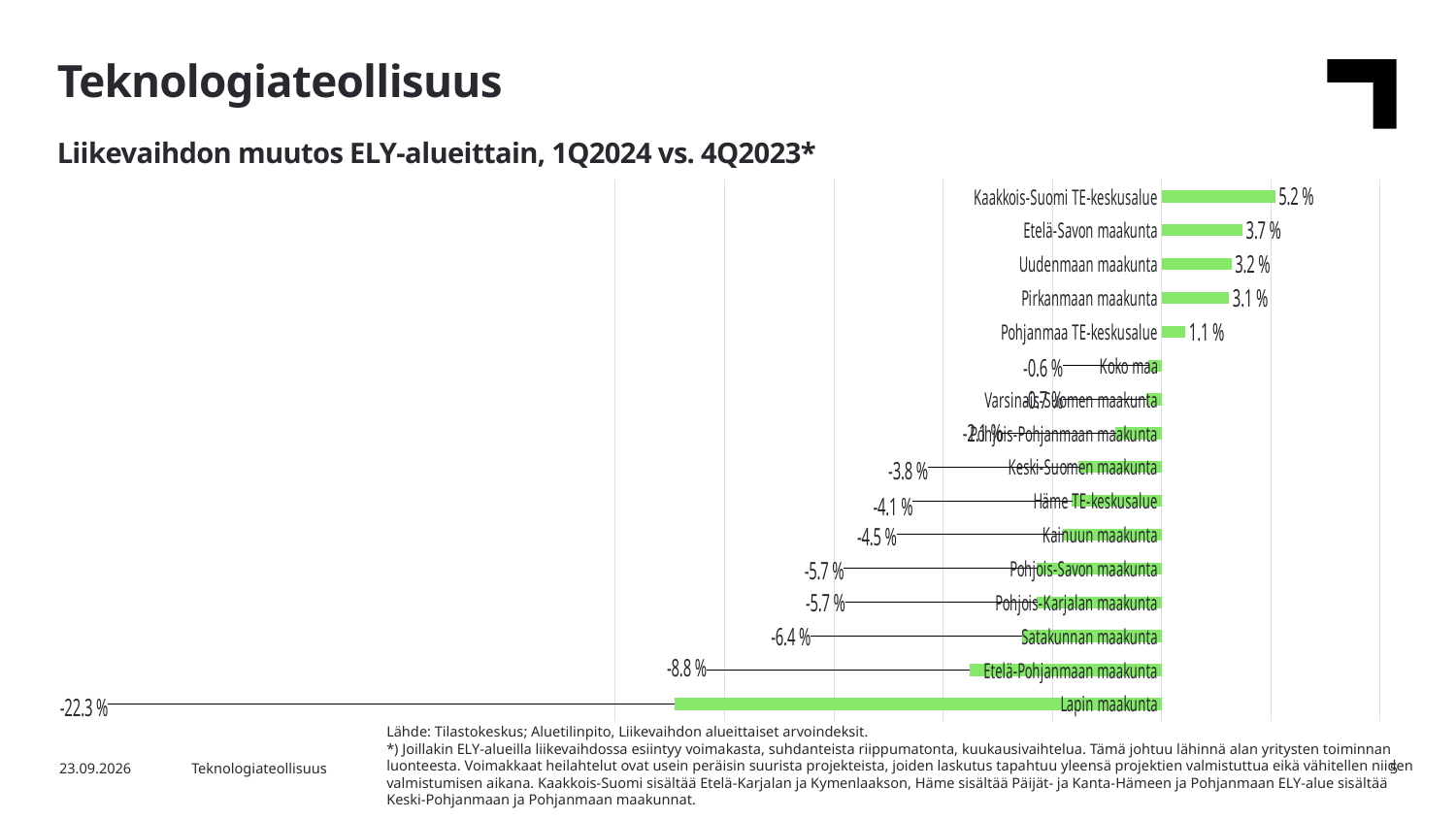
What is the difference between the values for Kaakkois-Suomi TE-keskusalue and Etelä-Savon maakunta? 1.5 % What is the title of the chart? Liikevaihdon muutos ELY-alueittain, 1Q2024 vs. 4Q2023* What is the value for Koko maa? -0.6 % Which is larger, the value for Uudenmaan maakunta or Pirkanmaan maakunta? Uudenmaan maakunta What is the value for Lapin maakunta? -22.3 % What kind of chart is shown on the slide? Bar chart Which region has the lowest value? Lapin maakunta How many regions are shown in the chart? 16 What is the difference between the values for Etelä-Pohjanmaan maakunta and Lapin maakunta? 13.5 % What is the value for Kaakkois-Suomi TE-keskusalue? 5.2 % Which region has the highest value? Kaakkois-Suomi TE-keskusalue What is the value for Satakunnan maakunta? -6.4 %